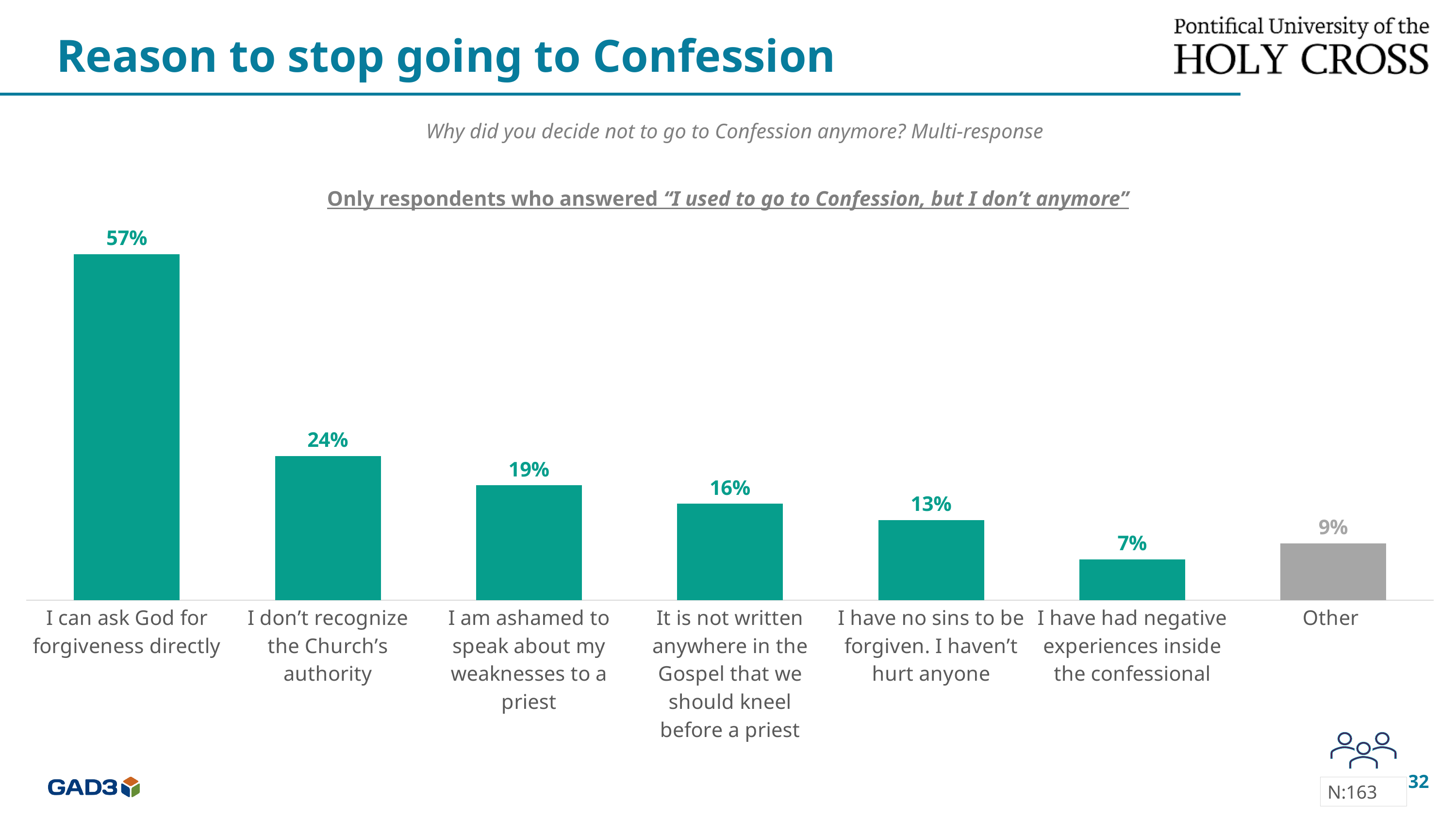
How many reason categories are shown in the chart? 7 What is the sample size (N) shown on the slide? 163 What is the value for "I don't recognize the Church's authority"? 24% Which reason has the lowest percentage? I have had negative experiences inside the confessional What percentage chose "I have had negative experiences inside the confessional"? 7% What is the value shown for "Other"? 9% What is the difference between "I can ask God for forgiveness directly" and "I don't recognize the Church's authority"? 33 percentage points What percentage of respondents said "I can ask God for forgiveness directly"? 57% Which is larger: "I am ashamed to speak about my weaknesses to a priest" or "I have no sins to be forgiven. I haven't hurt anyone"? I am ashamed to speak about my weaknesses to a priest Which reason has the highest percentage? I can ask God for forgiveness directly What kind of chart is shown on the slide? Bar chart